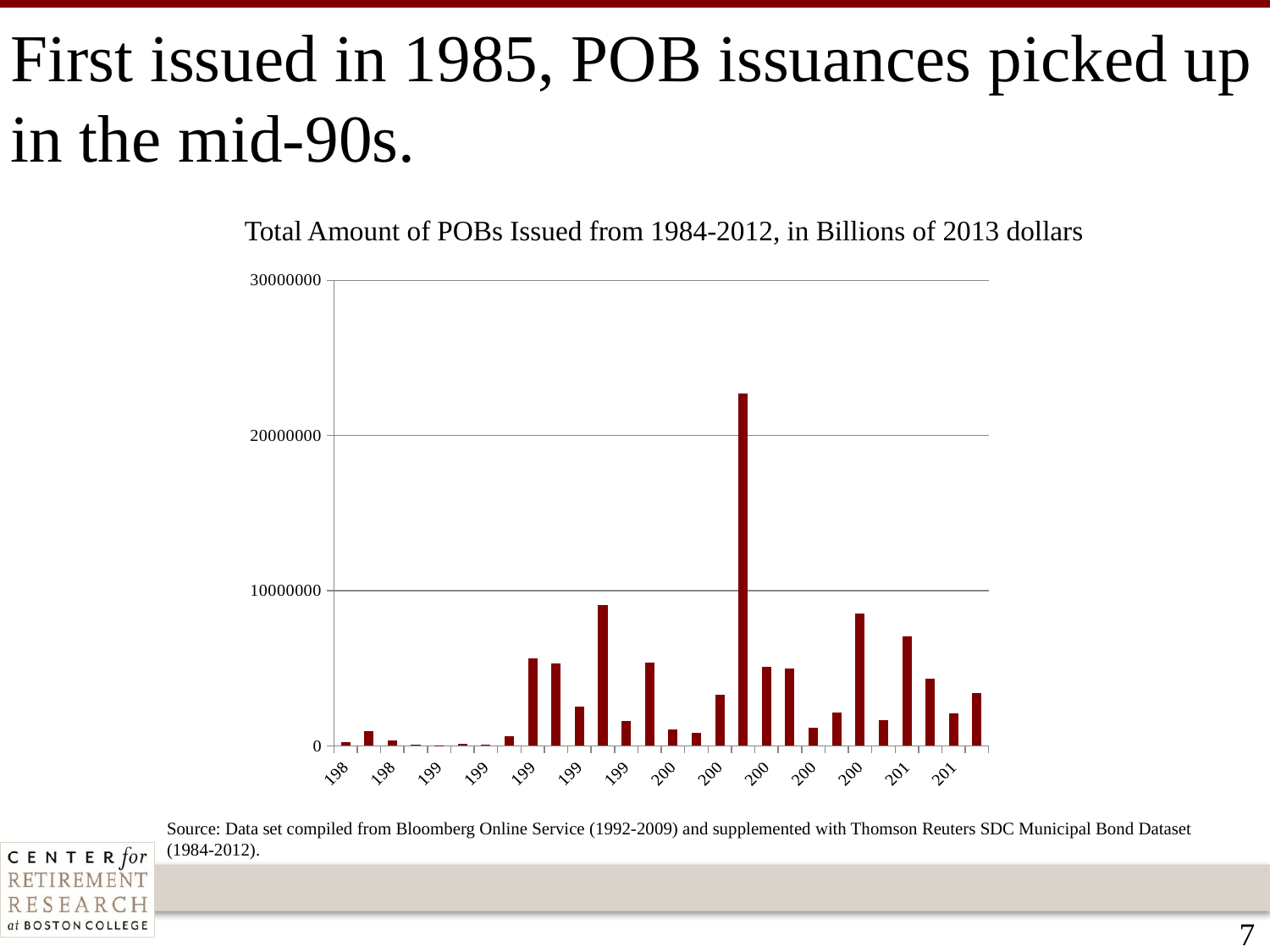
How many bars in the chart exceed 20000000? 1 Are the bars at the left (1980s) end of the chart generally taller or shorter than the bars in the middle and right of the chart? shorter What is the title of the chart? Total Amount of POBs Issued from 1984-2012, in Billions of 2013 dollars Is the tallest bar in the chart located in the left half or the right half of the x axis? right half Is the value of the second-tallest bar in the chart greater or less than 10000000? less How many bars in the chart exceed 10000000? 1 What colour are the bars in the chart? Dark red What kind of chart is shown on the slide? Bar chart What is the highest value shown on the y axis? 30000000 Is the value of the tallest bar in the chart greater or less than 20000000? greater Is the value of the tallest bar in the chart greater or less than 30000000? less